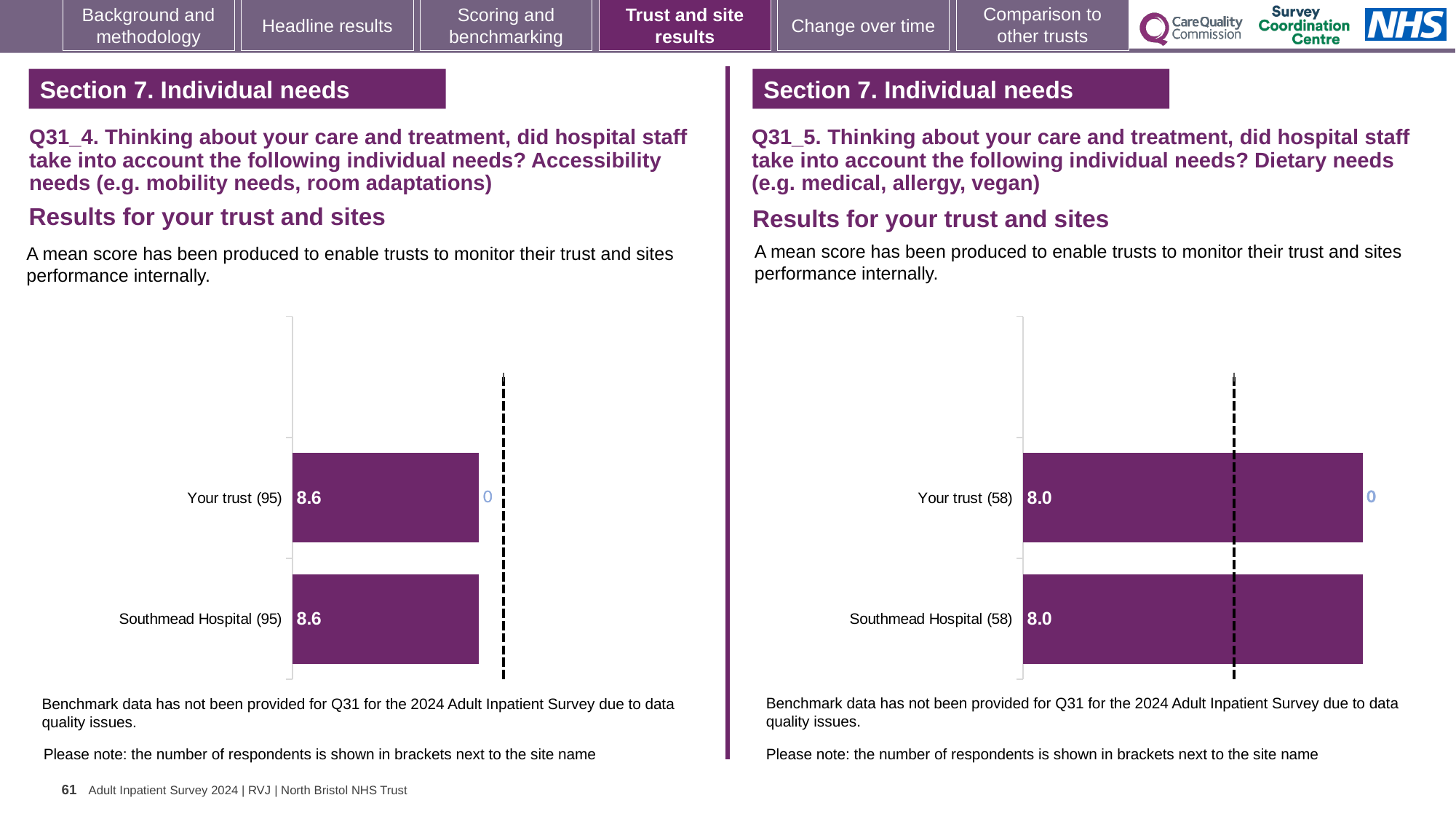
In the left chart (Q31_4, Accessibility needs), what is the mean score for Your trust? 8.6 How many bars are plotted in the right chart (Q31_5, Dietary needs)? 2 How many bars are plotted in the left chart (Q31_4, Accessibility needs)? 2 In the right chart (Q31_5, Dietary needs), how many respondents are shown in brackets next to Your trust? 58 In the right chart (Q31_5, Dietary needs), what is the mean score for Southmead Hospital? 8.0 What type of chart is used in the left chart (Q31_4, Accessibility needs)? Bar chart In the right chart (Q31_5, Dietary needs), what is the mean score for Your trust? 8.0 In the right chart (Q31_5, Dietary needs), what is the difference between the scores for Your trust and Southmead Hospital? 0.0 In the left chart (Q31_4, Accessibility needs), how many respondents are shown in brackets next to Southmead Hospital? 95 Is the Your trust score in the left chart (Q31_4, Accessibility needs) larger than the Your trust score in the right chart (Q31_5, Dietary needs)? Yes In the left chart (Q31_4, Accessibility needs), what is the difference between the scores for Your trust and Southmead Hospital? 0.0 In the left chart (Q31_4, Accessibility needs), what is the mean score for Southmead Hospital? 8.6